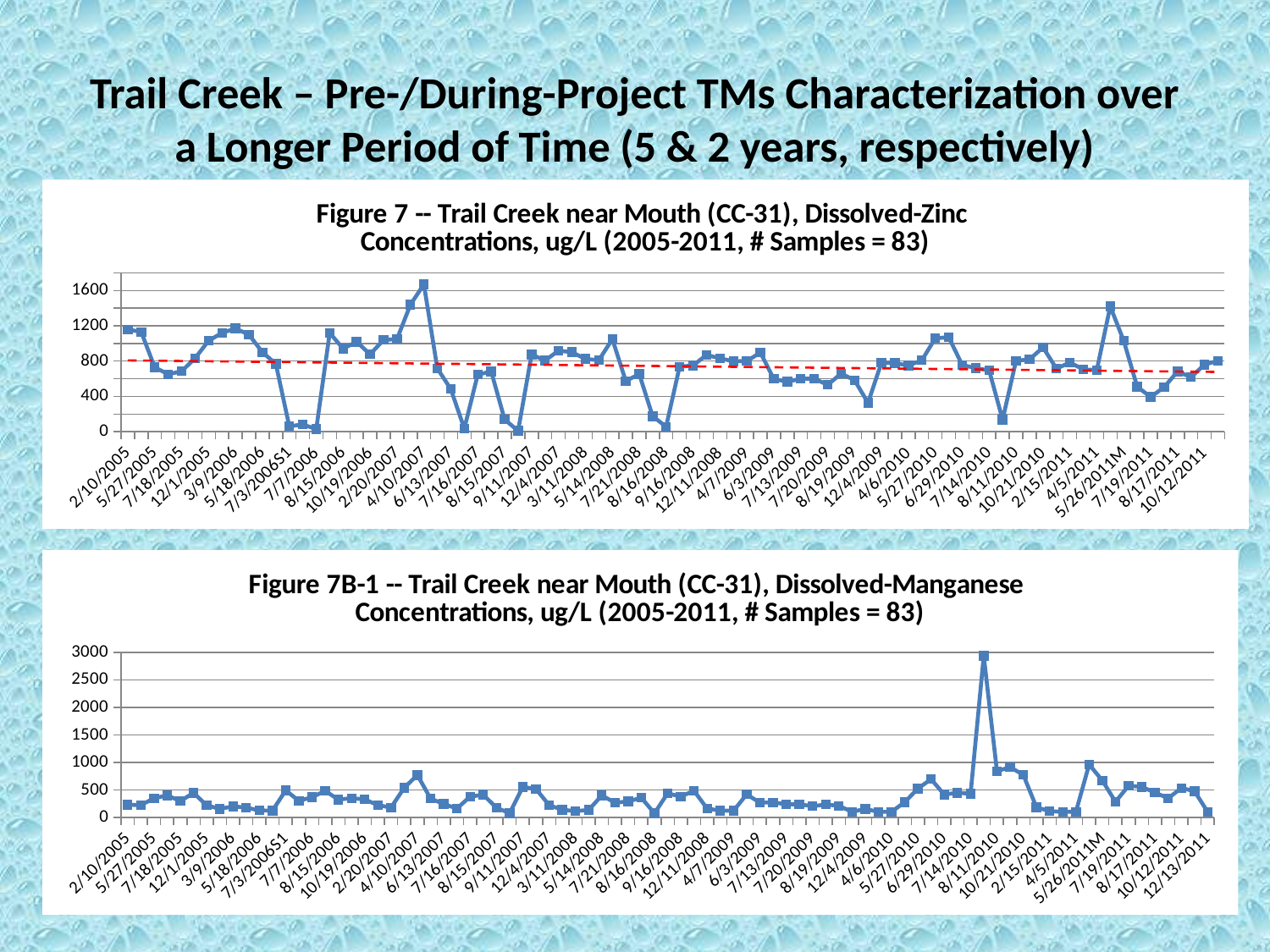
What is the highest value shown on the y axis of Figure 7B-1 (the bottom chart)? 3000 In Figure 7B-1 (the bottom chart), is the highest plotted value greater or less than 2500? greater What kind of chart is Figure 7 (the top chart)? line chart According to the title of Figure 7, how many samples are plotted? 83 Which metal's dissolved concentrations are plotted in Figure 7B-1 (the bottom chart)? Manganese How many charts are shown on the slide? 2 In Figure 7 (the top chart), which is larger, the value for 4/10/2007 or the value for 7/7/2006? 4/10/2007 In Figure 7B-1 (the bottom chart), is the value for 2/10/2005 greater or less than 500? less In Figure 7 (the top chart), does the dashed red trend line rise or fall from left to right? fall In Figure 7 (the top chart), is the value for 2/10/2005 greater or less than 800? greater